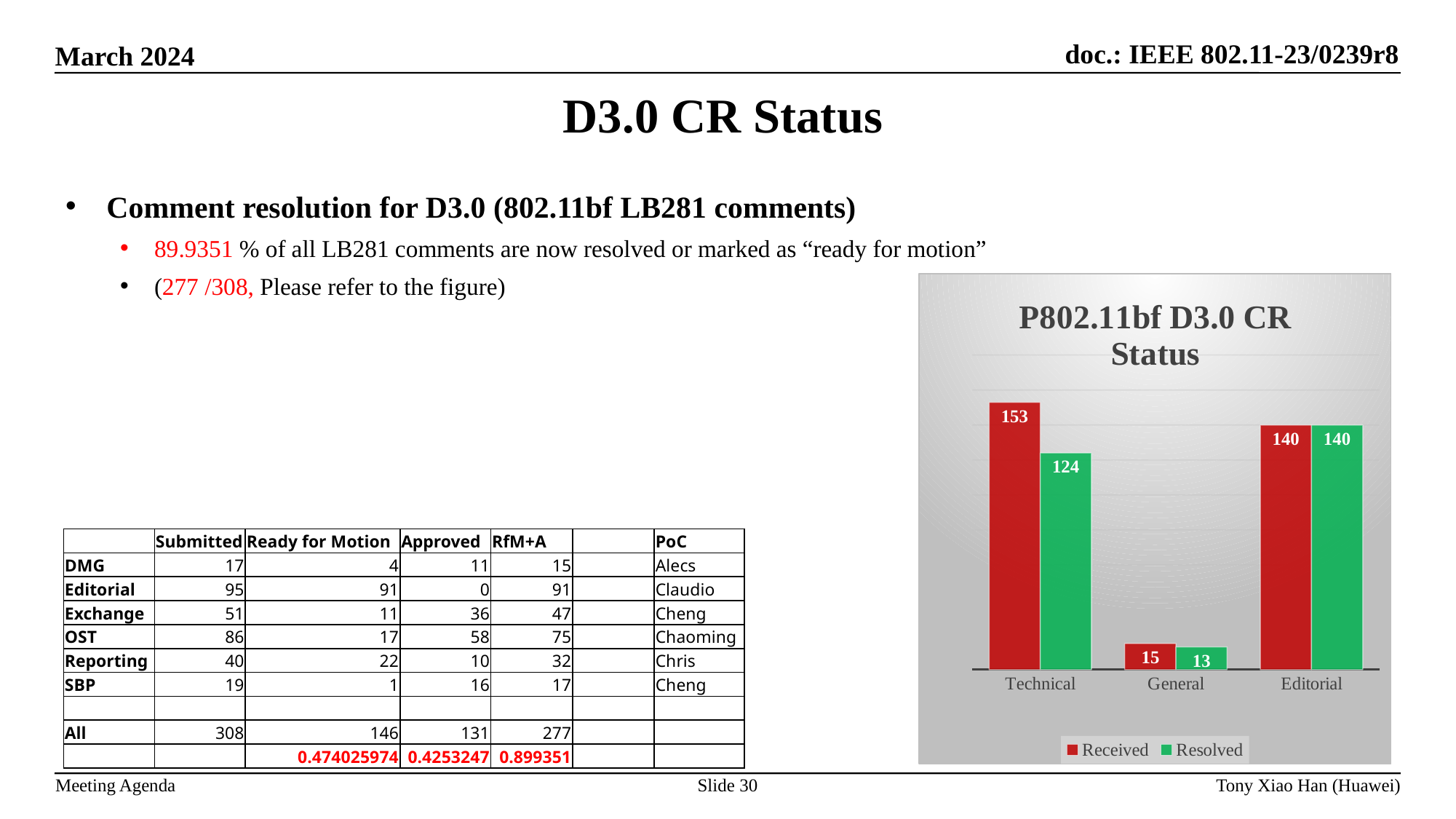
What is the Resolved value for Technical in the P802.11bf D3.0 CR Status chart? 124 How many series does the legend of the P802.11bf D3.0 CR Status chart list? 2 What colour are the Resolved bars in the P802.11bf D3.0 CR Status chart? green Which category has the highest Received value in the P802.11bf D3.0 CR Status chart? Technical What is the difference between Received and Resolved for Technical in the P802.11bf D3.0 CR Status chart? 29 What is the Resolved value for Editorial in the P802.11bf D3.0 CR Status chart? 140 In the P802.11bf D3.0 CR Status chart, is the Received value for General larger or smaller than the Resolved value for General? larger How many categories are shown on the x axis of the P802.11bf D3.0 CR Status chart? 3 What is the Received value for General in the P802.11bf D3.0 CR Status chart? 15 Which category has the lowest Resolved value in the P802.11bf D3.0 CR Status chart? General What is the Received value for Technical in the P802.11bf D3.0 CR Status chart? 153 What kind of chart is the P802.11bf D3.0 CR Status chart? bar chart